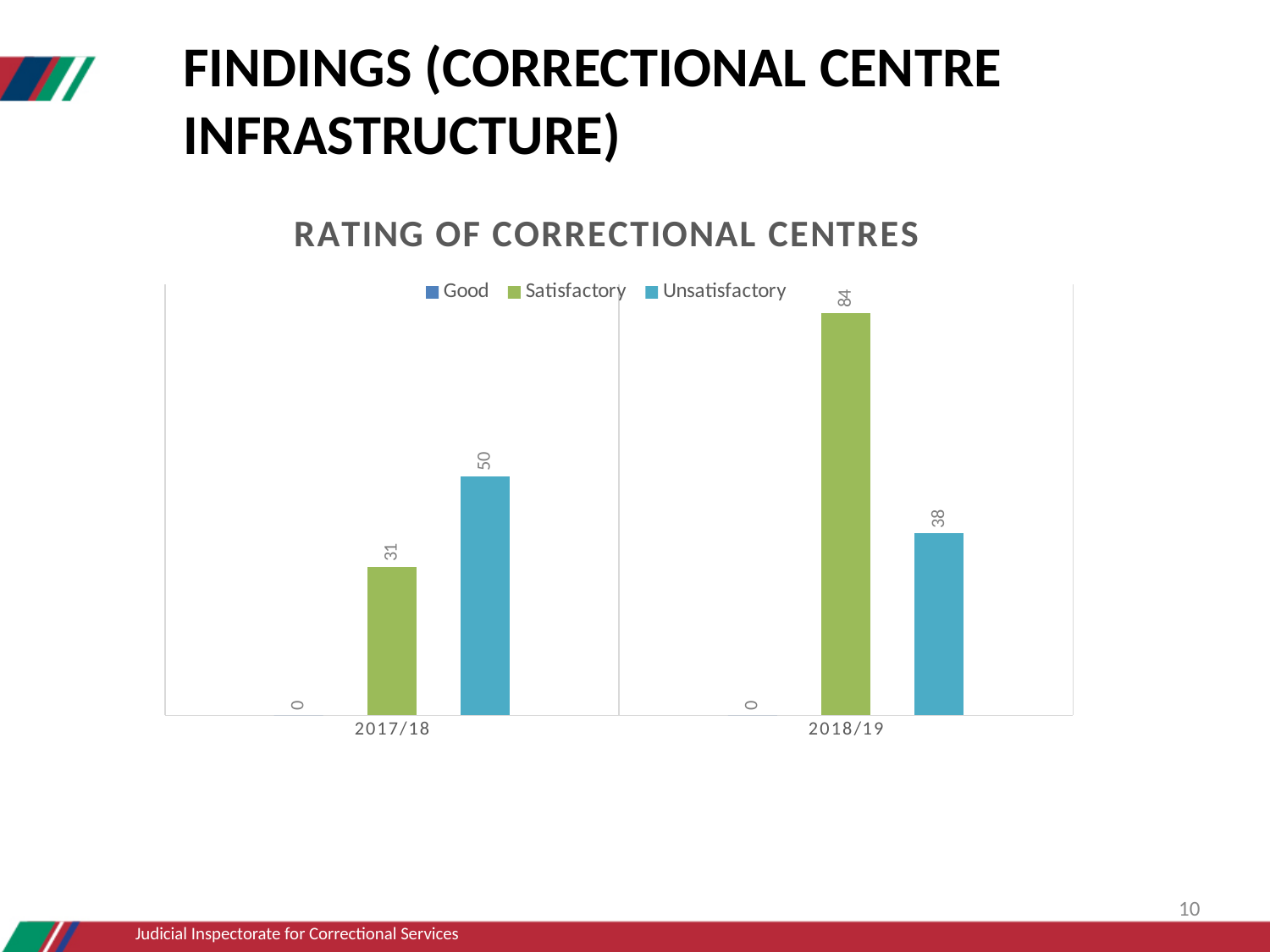
Which series has the highest value in 2017/18? Unsatisfactory What is the difference between the Satisfactory values for 2018/19 and 2017/18? 53 What is the difference between Unsatisfactory and Satisfactory in 2017/18? 19 How many series does the legend list? 3 Which is larger: Unsatisfactory in 2017/18 or Unsatisfactory in 2018/19? Unsatisfactory in 2017/18 What is the value for Satisfactory in 2017/18? 31 What is the value for Good in 2017/18? 0 What kind of chart is shown? Bar chart Which series has the highest value in 2018/19? Satisfactory What is the title of the chart? RATING OF CORRECTIONAL CENTRES What is the value for Unsatisfactory in 2018/19? 38 What is the value for Satisfactory in 2018/19? 84